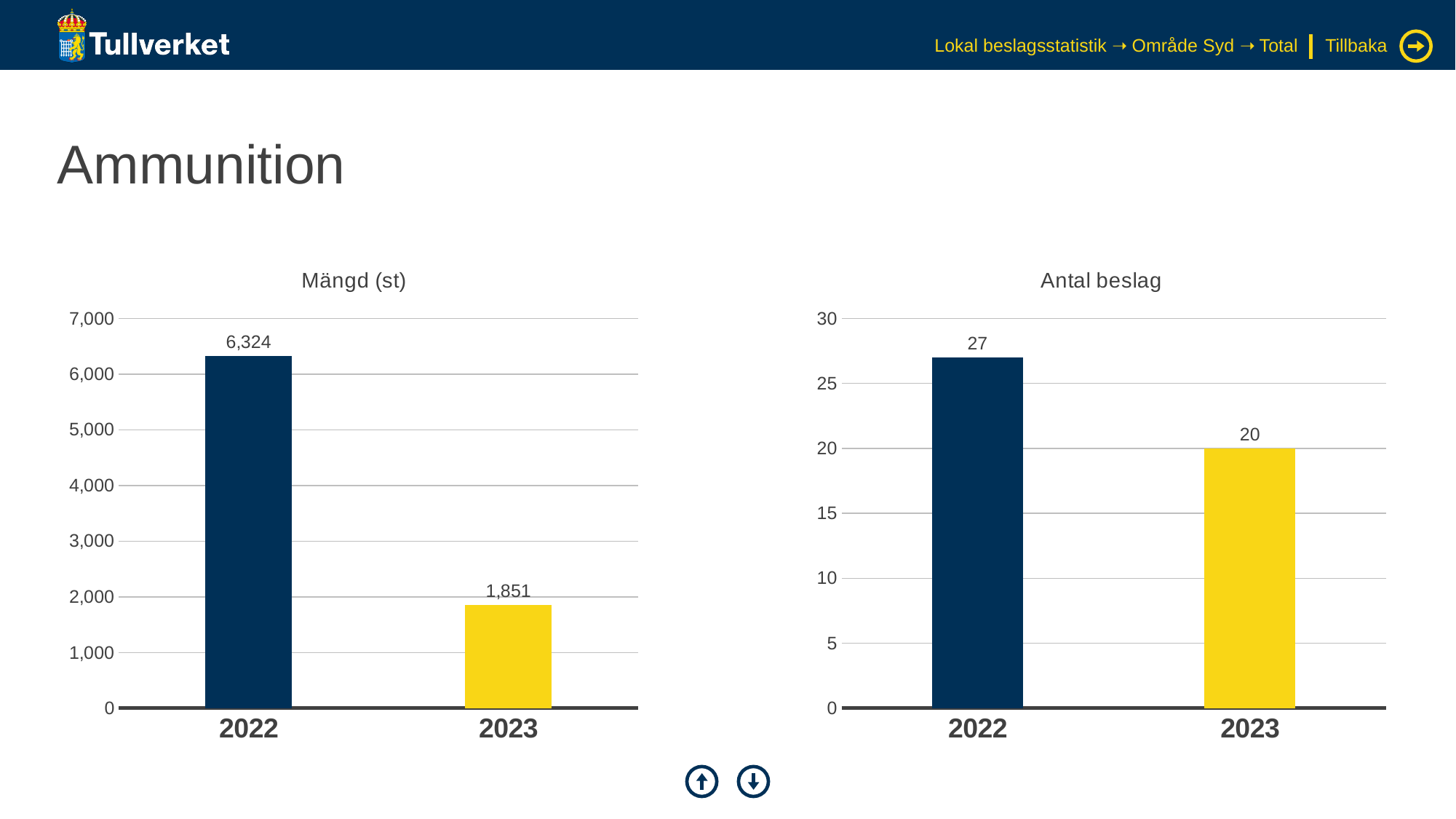
In the 'Antal beslag' chart, which year has the lowest value? 2023 In the 'Mängd (st)' chart, what is the value for 2022? 6,324 In the 'Mängd (st)' chart, which year has the highest value? 2022 In the 'Mängd (st)' chart, do the values rise or fall from 2022 to 2023? fall In the 'Antal beslag' chart, is the value for 2022 greater or less than 25? greater In the 'Mängd (st)' chart, what is the value for 2023? 1,851 In the 'Mängd (st)' chart, how many years are shown on the x axis? 2 What kind of chart is the 'Antal beslag' chart? bar chart In the 'Antal beslag' chart, what is the value for 2023? 20 In the 'Antal beslag' chart, what is the value for 2022? 27 In the 'Mängd (st)' chart, what is the difference between the 2022 and 2023 values? 4,473 In the 'Antal beslag' chart, what is the difference between the 2022 and 2023 values? 7